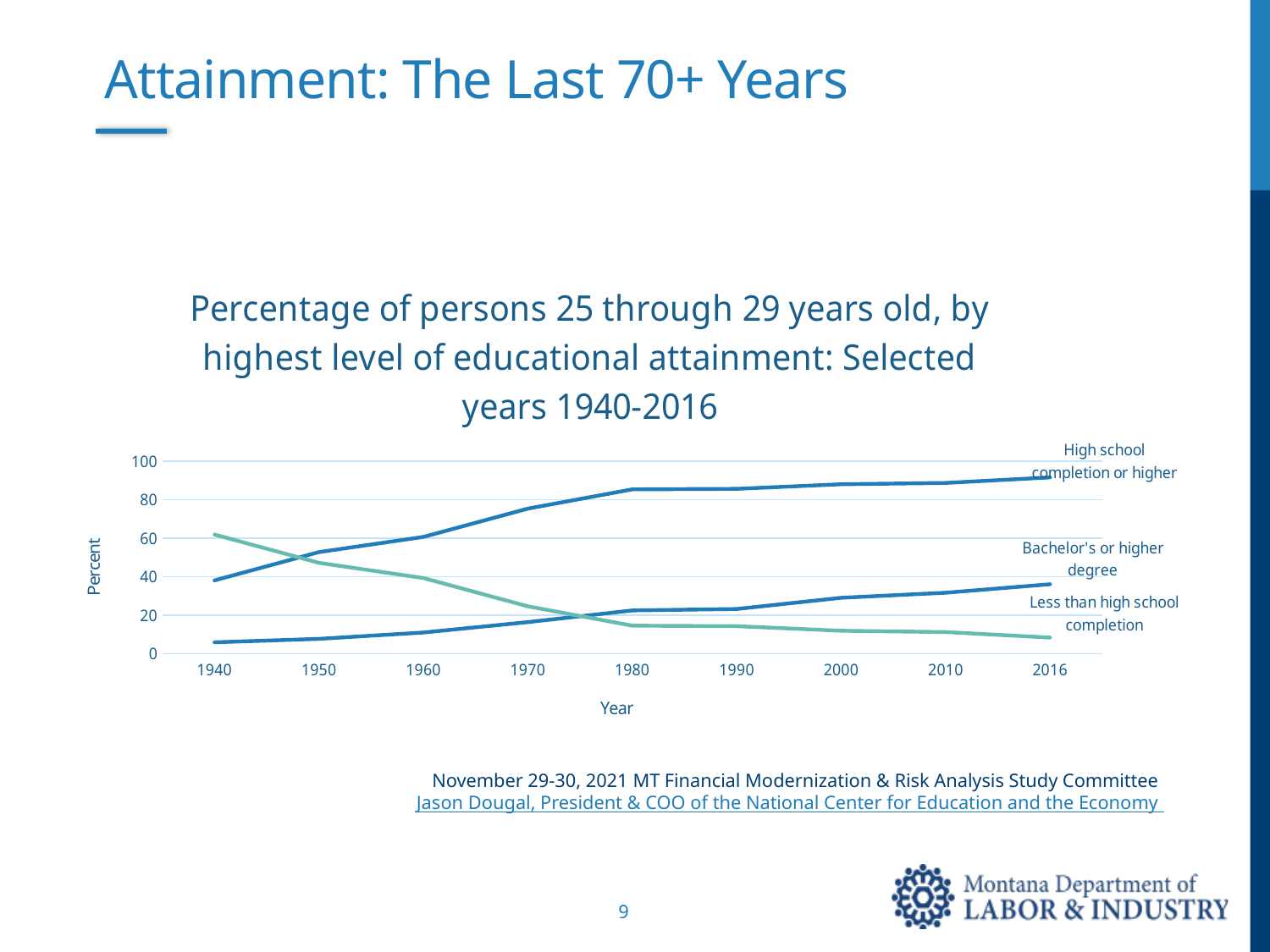
Does the 'Less than high school completion' line rise or fall from 1940 to 2016? fall In 1940, which was higher: 'Less than high school completion' or 'High school completion or higher'? Less than high school completion Is the value for 'Bachelor's or higher degree' in 2016 greater or less than 20? greater What is the label on the vertical axis of the chart? Percent Is the value for 'Less than high school completion' in 2016 greater or less than 20? less In 2016, which was higher: 'High school completion or higher' or 'Bachelor's or higher degree'? High school completion or higher Is the value for 'Bachelor's or higher degree' in 1940 greater or less than 20? less How many series are plotted in the chart? 3 How many years are shown along the x axis? 9 Does the 'High school completion or higher' line rise or fall from 1940 to 2016? rise What kind of chart is shown on the slide? line chart